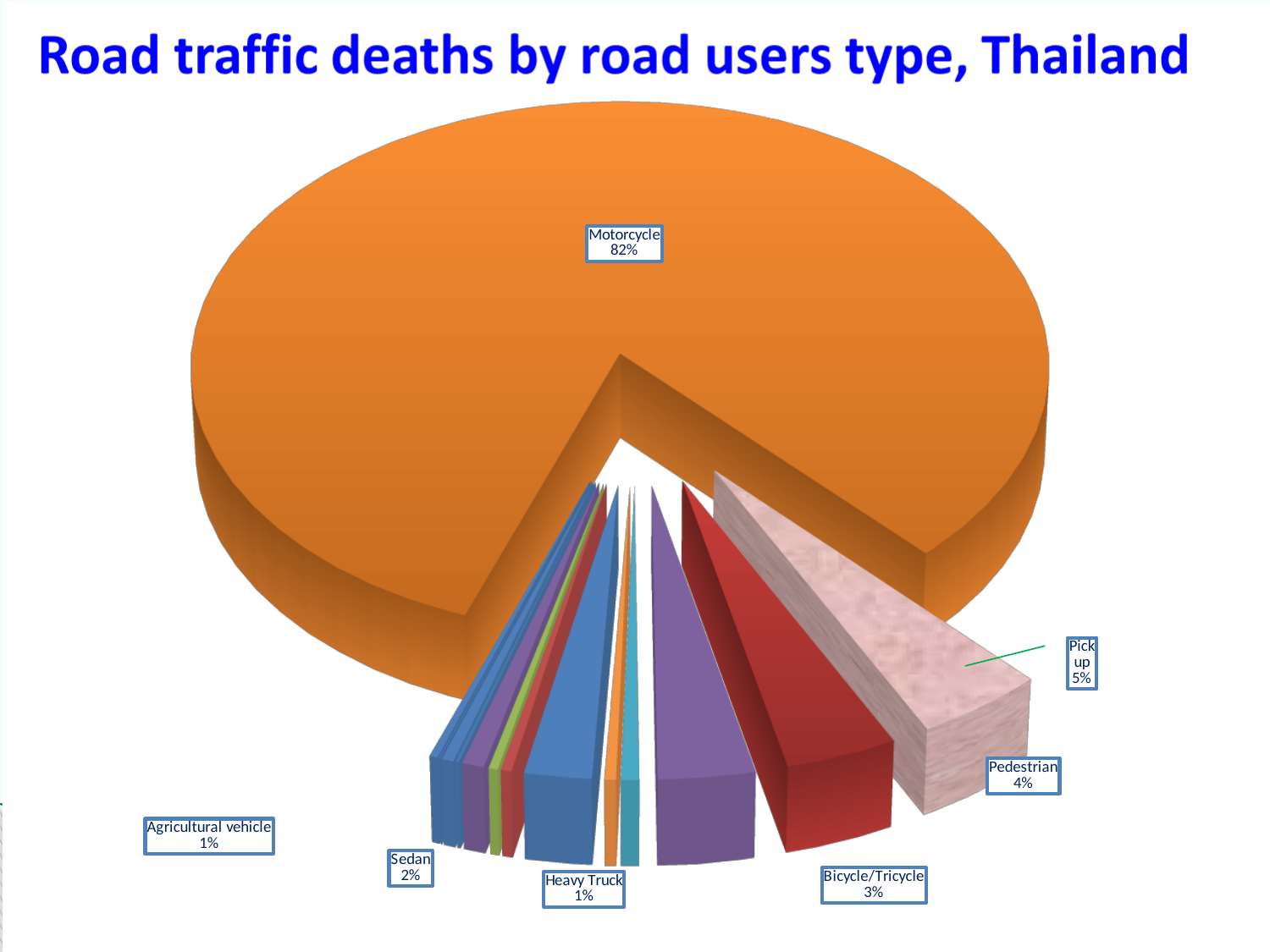
What is the title of the chart? Road traffic deaths by road users type, Thailand What share of road traffic deaths is attributed to Motorcycle? 82% Which is larger, the share for Pick up or the share for Pedestrian? Pick up What is the difference in percentage points between the Pedestrian share and the Sedan share? 2 Which road user type accounts for the largest share of road traffic deaths? Motorcycle What kind of chart is shown on the slide? Pie chart What is the difference in percentage points between the Motorcycle share and the Pick up share? 77 What percentage is shown for Bicycle/Tricycle? 3% What percentage of road traffic deaths is shown for Pick up? 5% What share of deaths is attributed to Sedan? 2% What is the share for Pedestrian? 4% What percentage is shown for Heavy Truck? 1%